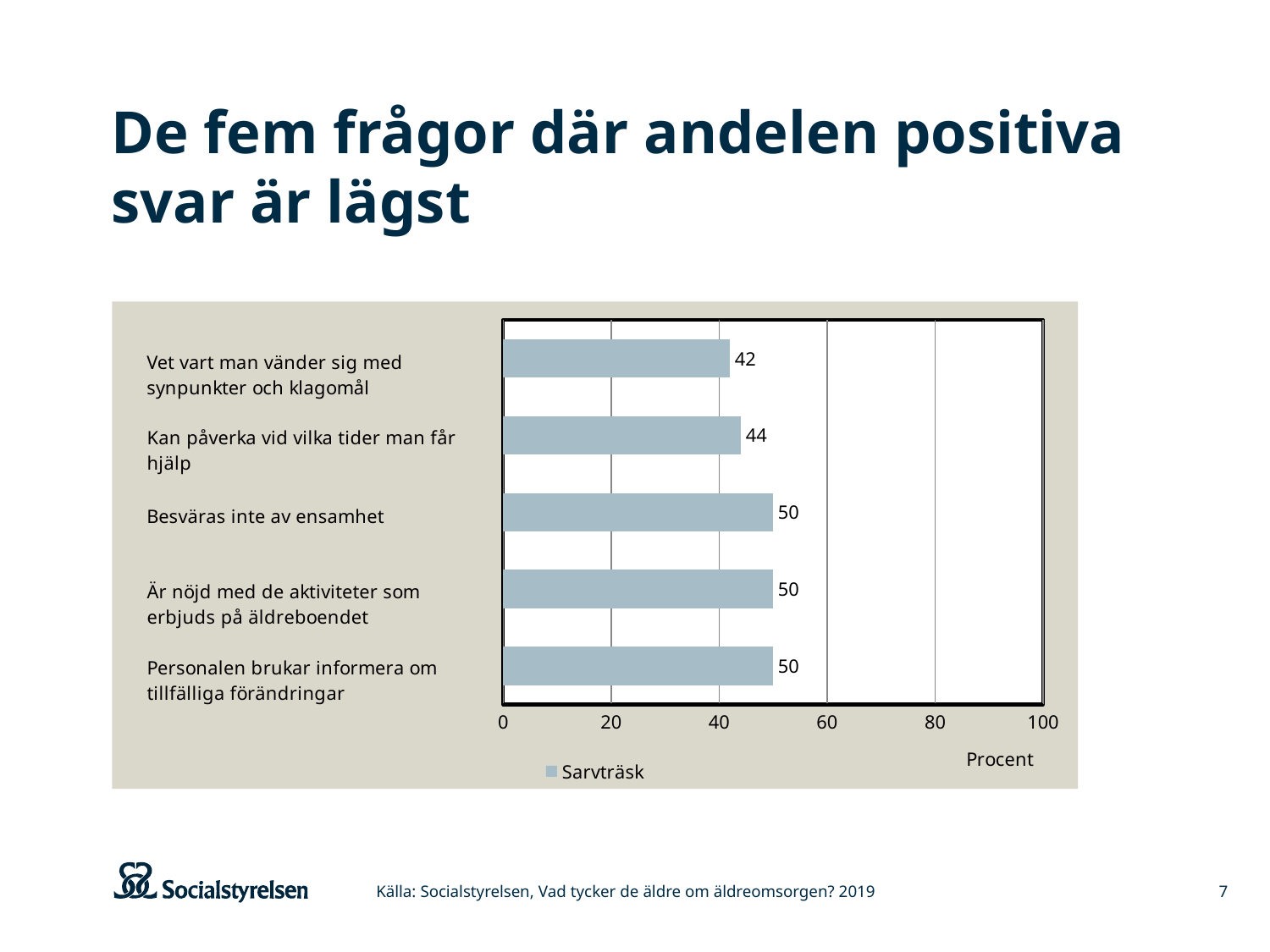
Which is larger, the value for "Kan påverka vid vilka tider man får hjälp" or the value for "Är nöjd med de aktiviteter som erbjuds på äldreboendet"? Är nöjd med de aktiviteter som erbjuds på äldreboendet How many categories are shown in the chart? 5 What is the value for "Kan påverka vid vilka tider man får hjälp"? 44 What is the value for "Besväras inte av ensamhet"? 50 What is the difference between the values for "Besväras inte av ensamhet" and "Vet vart man vänder sig med synpunkter och klagomål"? 8 What is the value for "Personalen brukar informera om tillfälliga förändringar"? 50 Which category has the lowest value? Vet vart man vänder sig med synpunkter och klagomål Is the value for "Vet vart man vänder sig med synpunkter och klagomål" greater or less than 60? less What kind of chart is shown on the slide? bar chart What is the difference between the values for "Kan påverka vid vilka tider man får hjälp" and "Vet vart man vänder sig med synpunkter och klagomål"? 2 What is the value for "Vet vart man vänder sig med synpunkter och klagomål"? 42 What series does the legend list? Sarvträsk